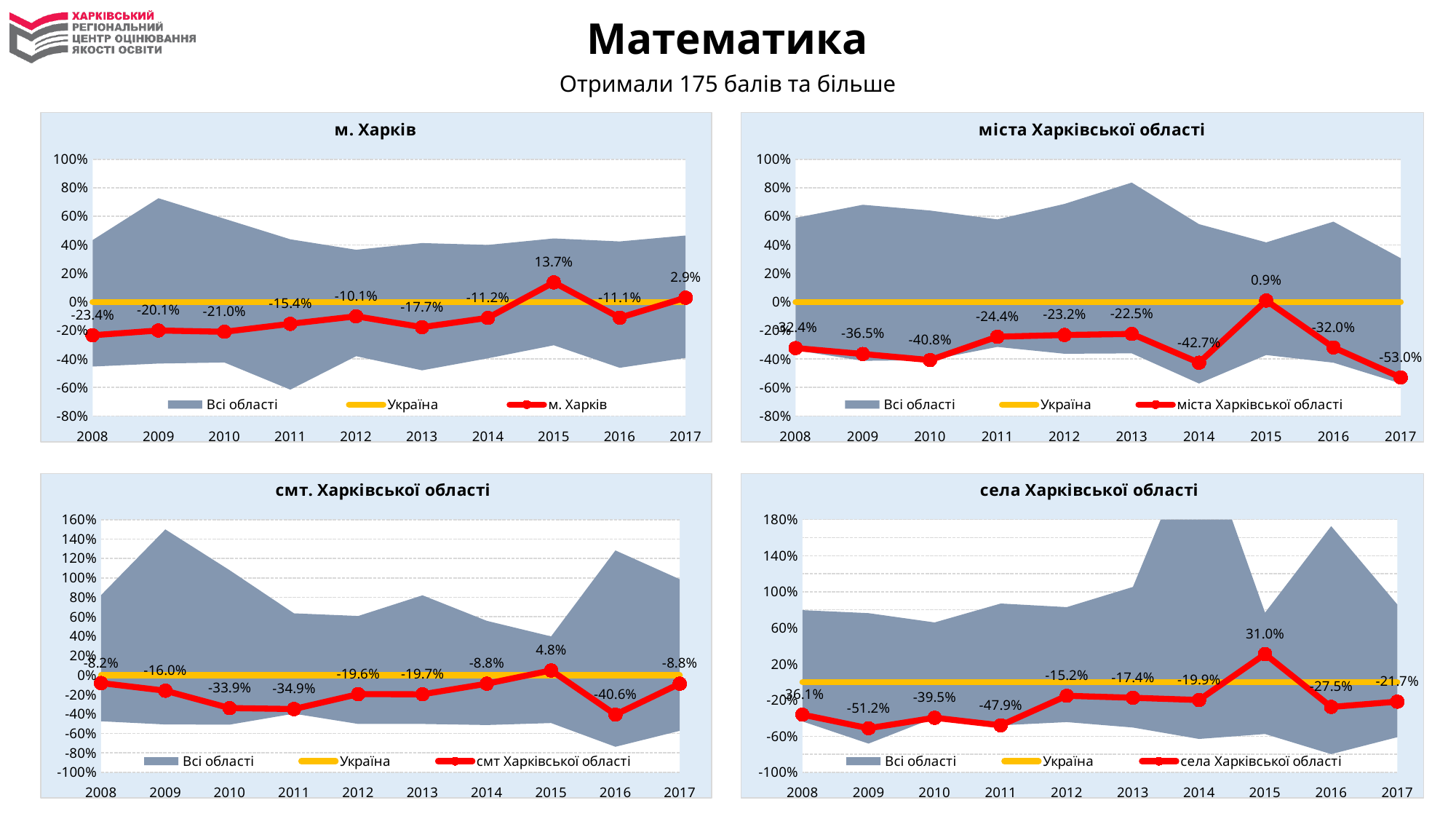
In the chart titled "смт. Харківської області", what is the value of the red line for 2016? -40.6% In the chart titled "м. Харків", what is the difference between the red line values for 2015 and 2016? 24.8 percentage points How many years are shown on the x axis of the chart titled "села Харківської області"? 10 In the chart titled "міста Харківської області", what is the value of the red line for 2017? -53.0% How many series does the legend list in the chart titled "смт. Харківської області"? 3 In the chart titled "міста Харківської області", which is larger: the red line value for 2011 or for 2014? 2011 In the chart titled "села Харківської області", which year has the lowest value on the red line? 2009 In the chart titled "села Харківської області", what is the value of the red line for 2015? 31.0% In the chart titled "міста Харківської області", which year has the highest value on the red line? 2015 In the chart titled "м. Харків", what is the value of the red line for 2015? 13.7% In the chart titled "смт. Харківської області", which year has the lowest value on the red line? 2016 In the chart titled "м. Харків", what is the value of the red line for 2017? 2.9%